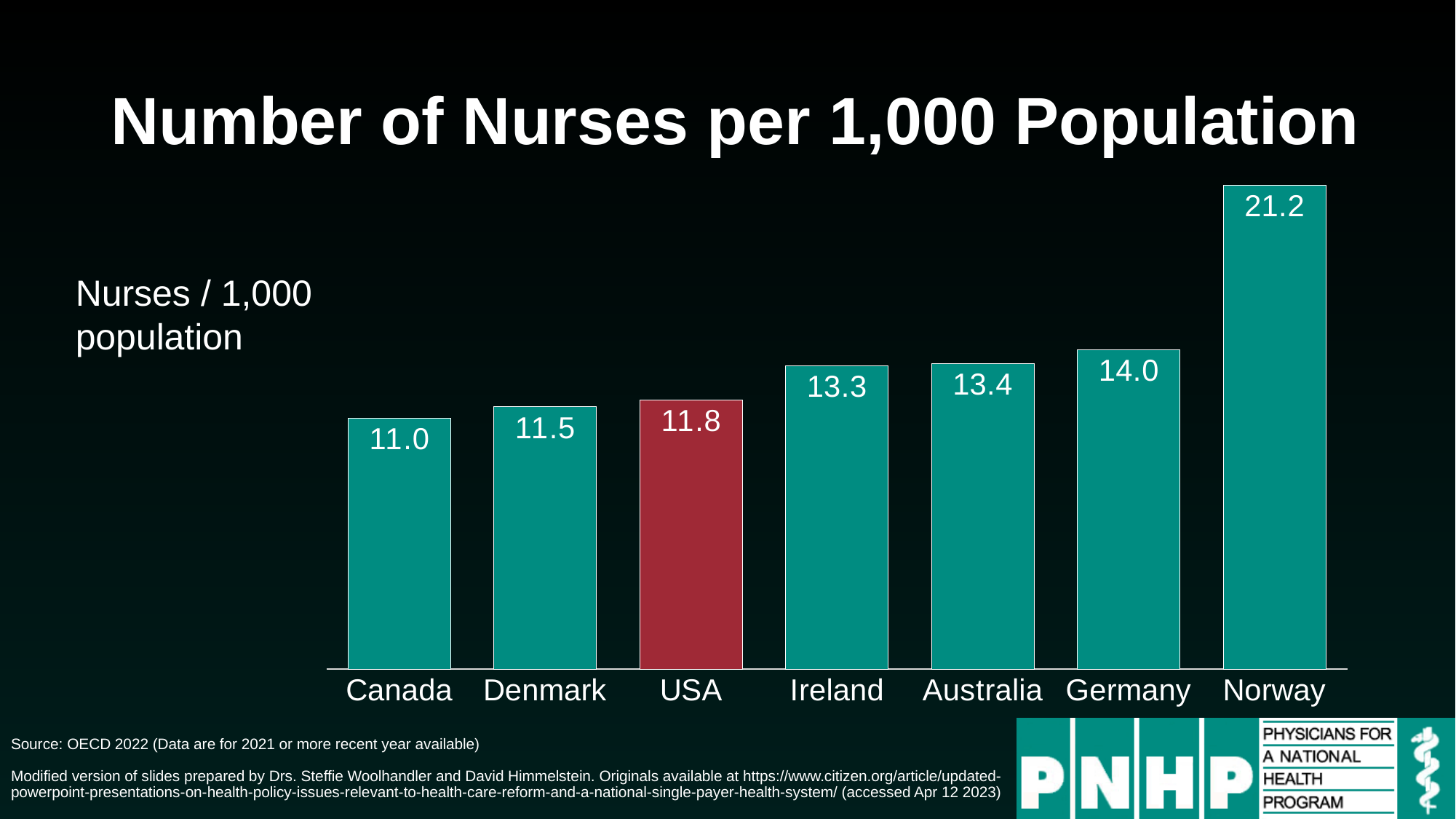
What is the value shown for Germany? 14.0 Which country's bar is coloured differently (red) from the others? USA Which country has the highest number of nurses per 1,000 population? Norway What is the number of nurses per 1,000 population for the USA? 11.8 What is the difference between Germany's and Canada's values? 3.0 What is the difference between Norway's and the USA's values? 9.4 Which country has the lowest number of nurses per 1,000 population? Canada Which has a higher value, Denmark or Ireland? Ireland What kind of chart is shown on the slide? Bar chart Do the values rise or fall from left to right across the countries? Rise What is the number of nurses per 1,000 population for Norway? 21.2 How many countries are shown in the chart? 7